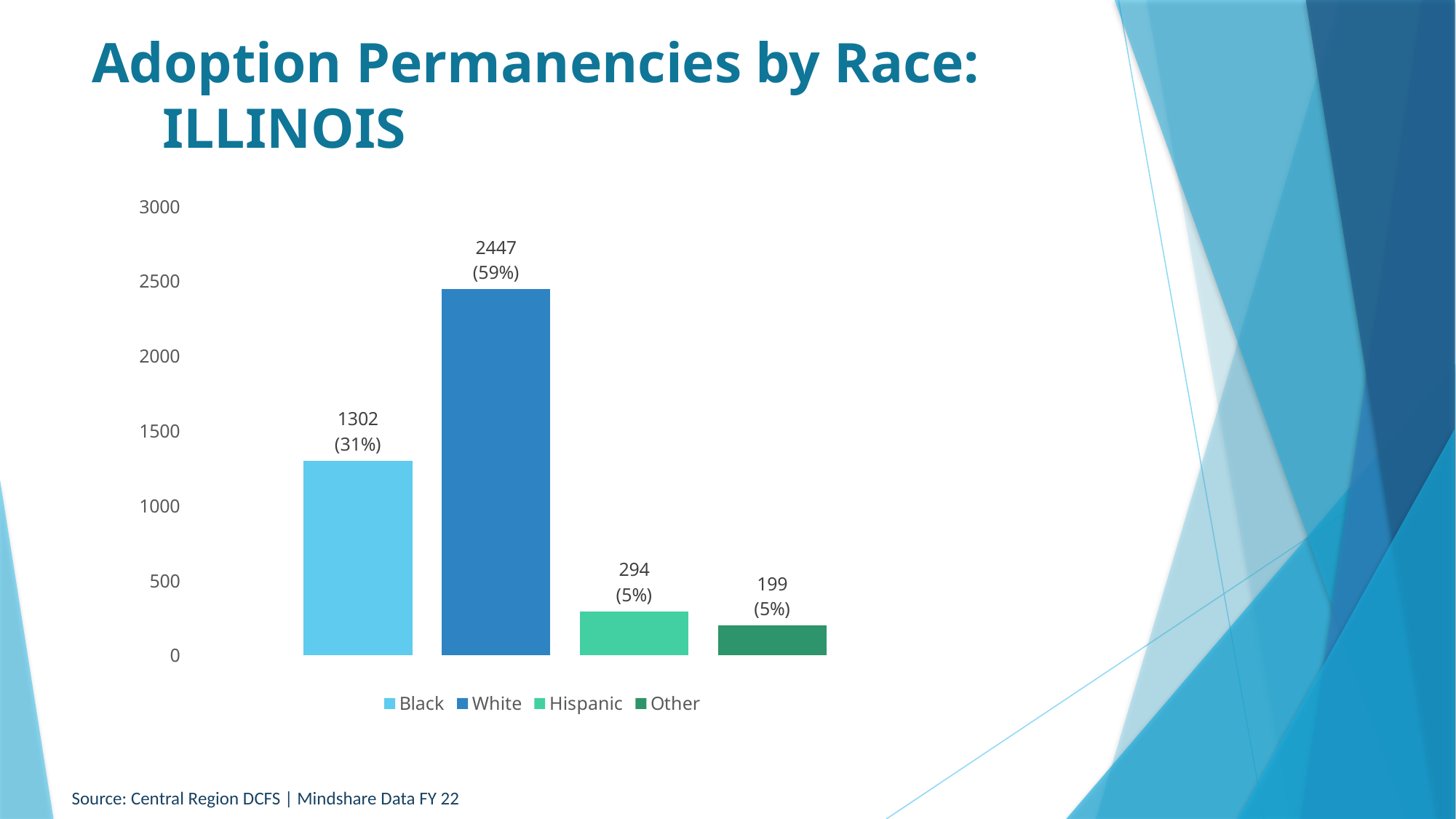
How many categories are shown in the chart? 4 Which category has the lowest value? Other What is the title of the slide? Adoption Permanencies by Race: ILLINOIS What kind of chart is shown on the slide? Bar chart Is the value for Black greater or less than 1000? greater What is the value for White? 2447 (59%) What is the value for Hispanic? 294 (5%) What is the difference between the values for White and Black? 1145 Which is larger, the value for Hispanic or the value for Other? Hispanic Which category has the highest value? White What is the value for Other? 199 (5%) What is the value for Black? 1302 (31%)